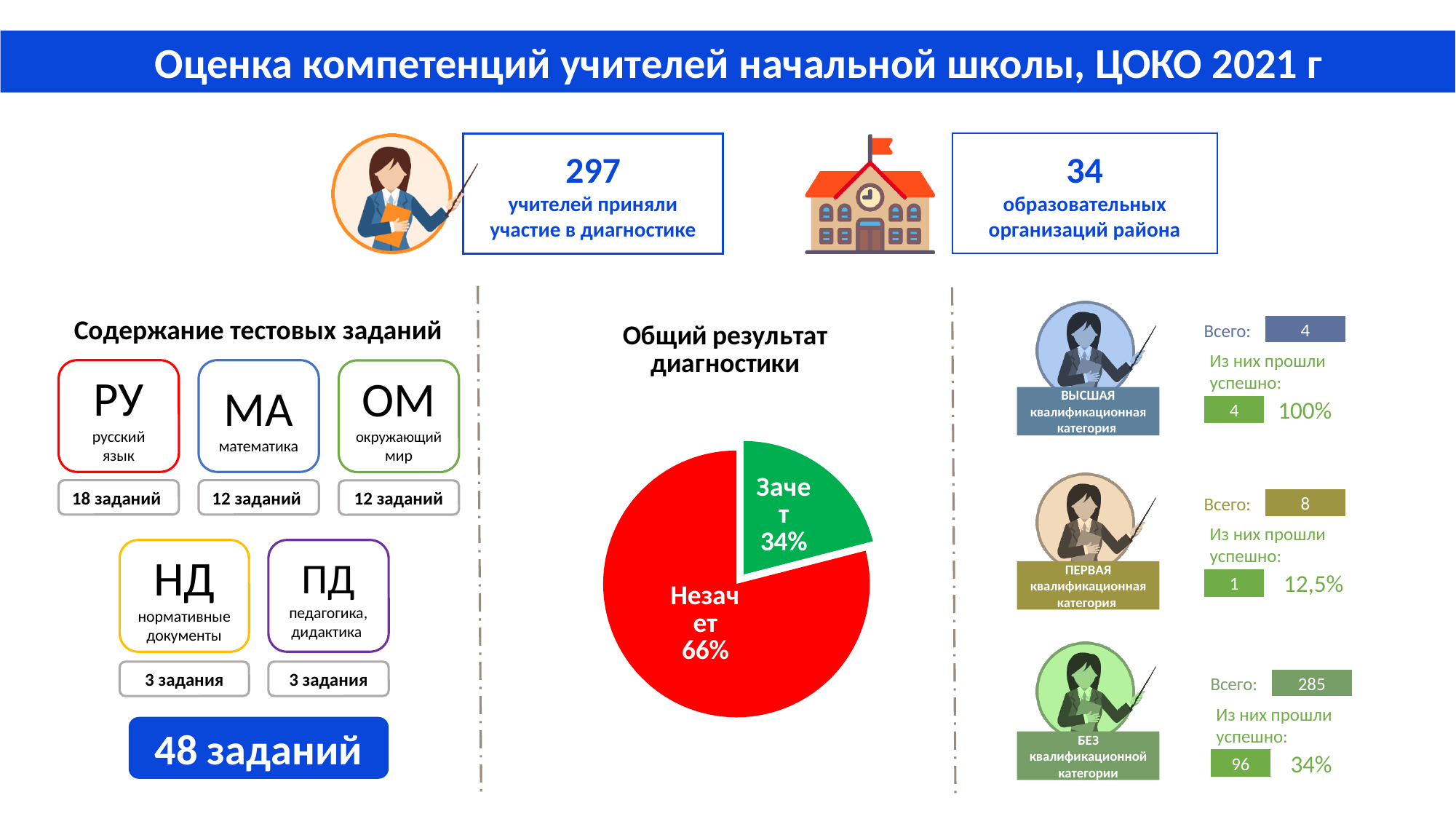
By how many percentage points does the "Незачет" slice exceed the "Зачет" slice? 32 percentage points Which is larger in the pie chart, "Зачет" or "Незачет"? Незачет What kind of chart is shown in the middle of the slide? Pie chart Which slice of the pie chart is the largest? Незачет Which slice of the pie chart is the smallest? Зачет How many slices does the pie chart have? 2 What share of the pie chart does the "Незачет" slice represent? 66% What share of the pie chart does the "Зачет" slice represent? 34% What colour is the "Незачет" slice of the pie chart? Red What is the title of the pie chart? Общий результат диагностики Is the share of the "Зачет" slice greater or less than 50%? less